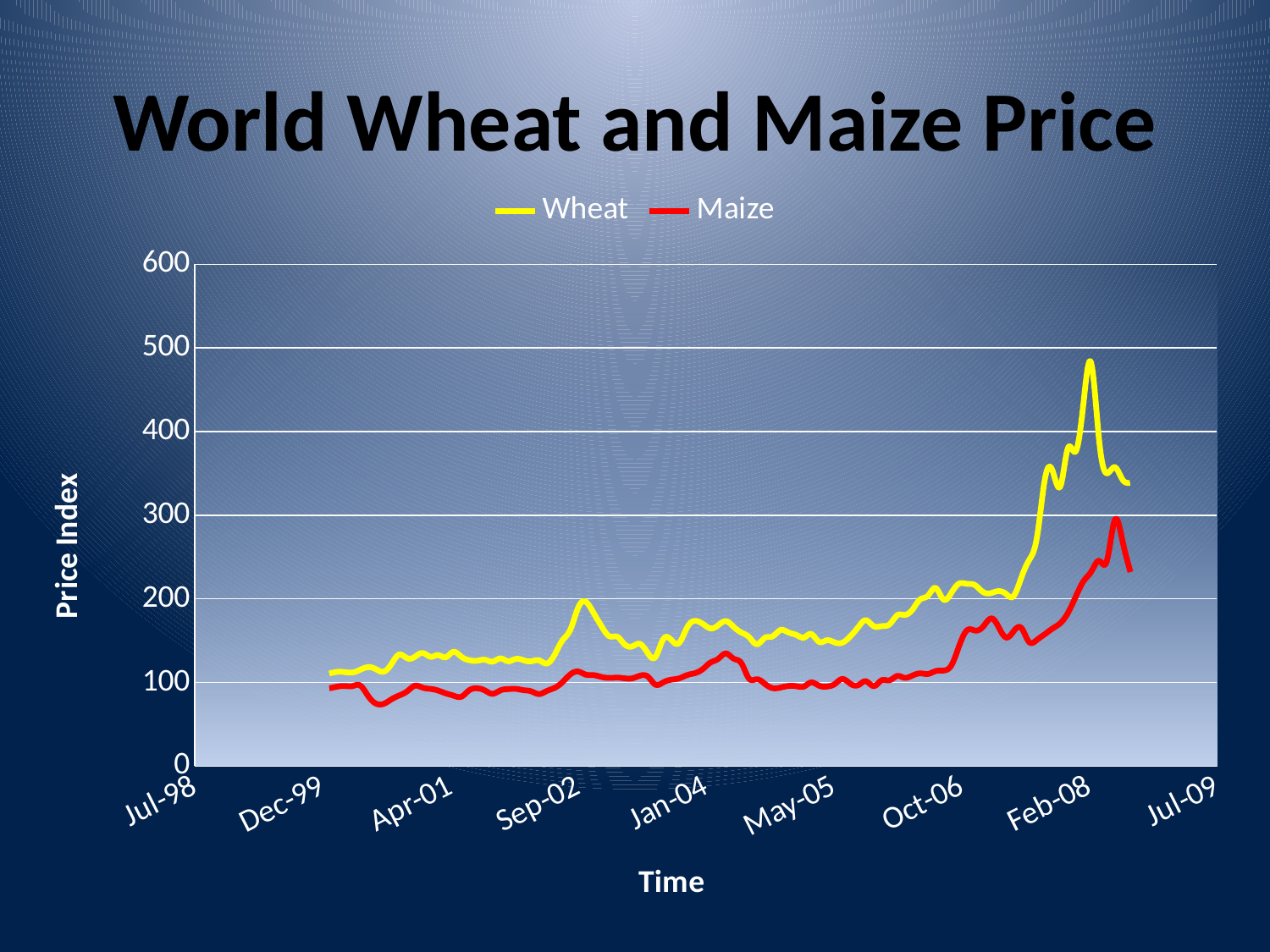
Which series reaches the higher peak value, Wheat or Maize? Wheat Which series is higher at Feb-08, Wheat or Maize? Wheat Is the Maize value at Oct-06 greater or less than 200? less Is the highest value reached by the Wheat series greater or less than 400? greater Is the Wheat value at Jan-04 greater or less than 200? less Overall, does the Wheat series rise or fall from the start of the period to the end? rise How many series does the legend list? 2 What kind of chart is shown on the slide? line chart Which colour represents the Maize series? red What is the title of the chart? World Wheat and Maize Price